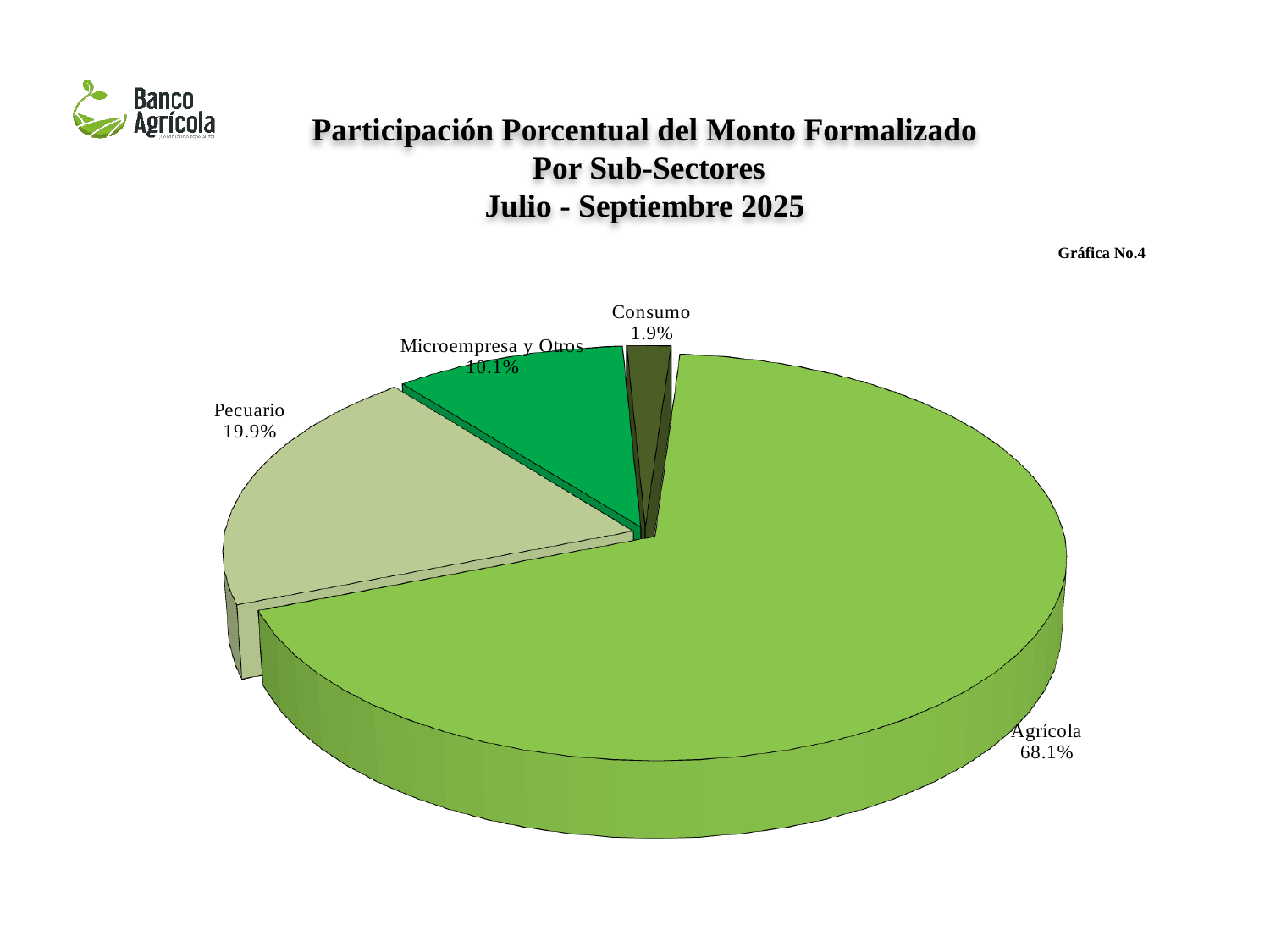
What is the difference in percentage points between Pecuario and Microempresa y Otros? 9.8 Which sub-sector has the largest share of the pie? Agrícola What is the difference in percentage points between Agrícola and Pecuario? 48.2 How many slices does the pie chart have? 4 What share of the pie does Agrícola represent? 68.1% What period does the chart title say the data covers? Julio - Septiembre 2025 What is the value shown for Microempresa y Otros? 10.1% What is the value shown for Pecuario? 19.9% What is the value shown for Consumo? 1.9% Which is larger, the share for Pecuario or the share for Microempresa y Otros? Pecuario What type of chart is shown on the slide? Pie chart Which sub-sector has the smallest share of the pie? Consumo